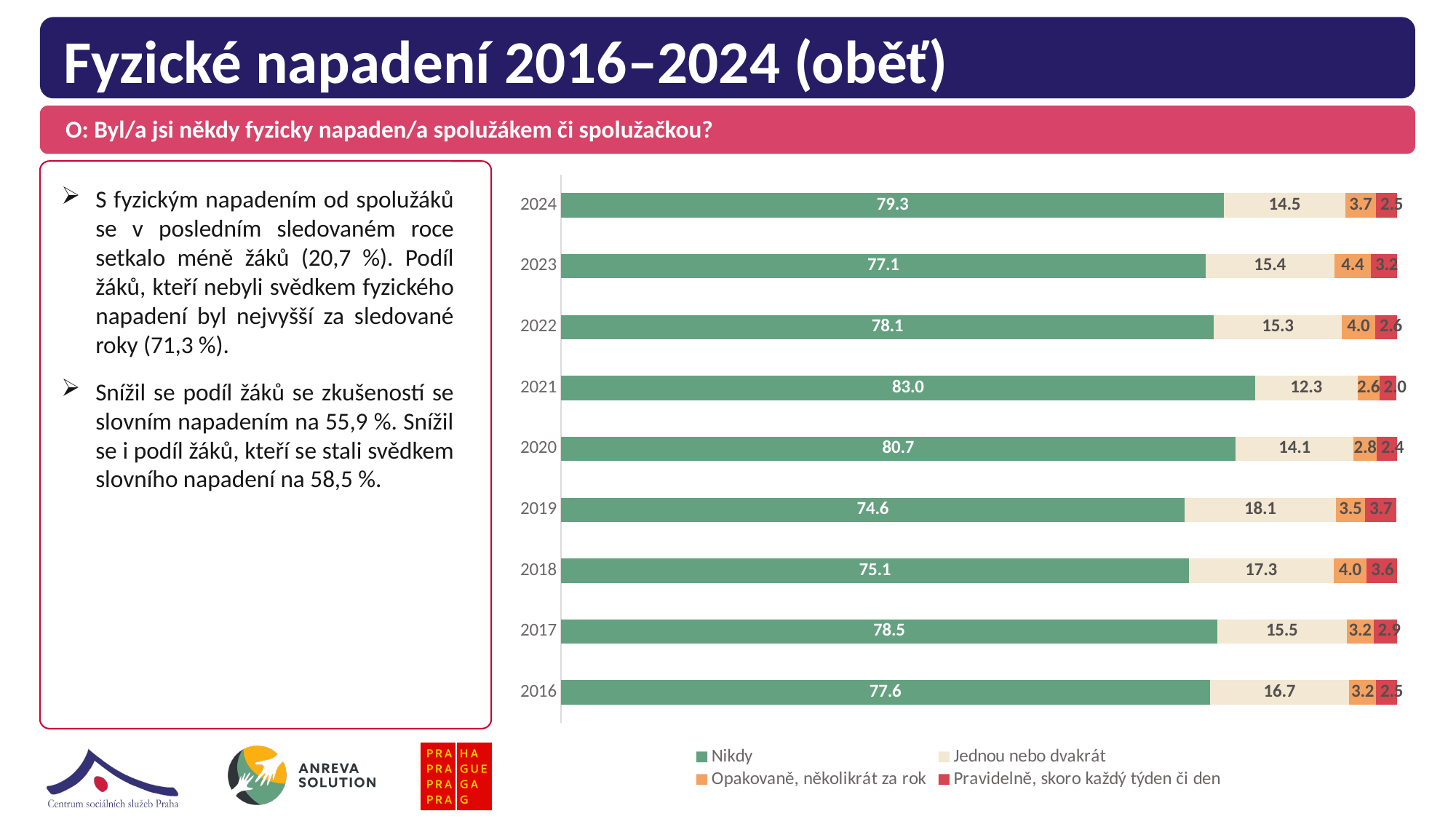
Which is larger: the 'Jednou nebo dvakrát' value for 2018 or for 2017? 2018 In which year is the 'Nikdy' value the lowest? 2019 How many series does the legend list? 4 How many years are shown on the chart? 9 What is the value of the 'Jednou nebo dvakrát' series for 2019? 18.1 What kind of chart is shown on the slide? Stacked bar chart What is the value of the 'Opakovaně, několikrát za rok' series for 2023? 4.4 What is the total of the stacked bar for 2024? 100.0 What is the value of the 'Pravidelně, skoro každý týden či den' series for 2016? 2.5 What is the difference between the 'Nikdy' values for 2024 and 2023? 2.2 In which year is the 'Nikdy' value the highest? 2021 What is the value of the 'Nikdy' series for 2024? 79.3